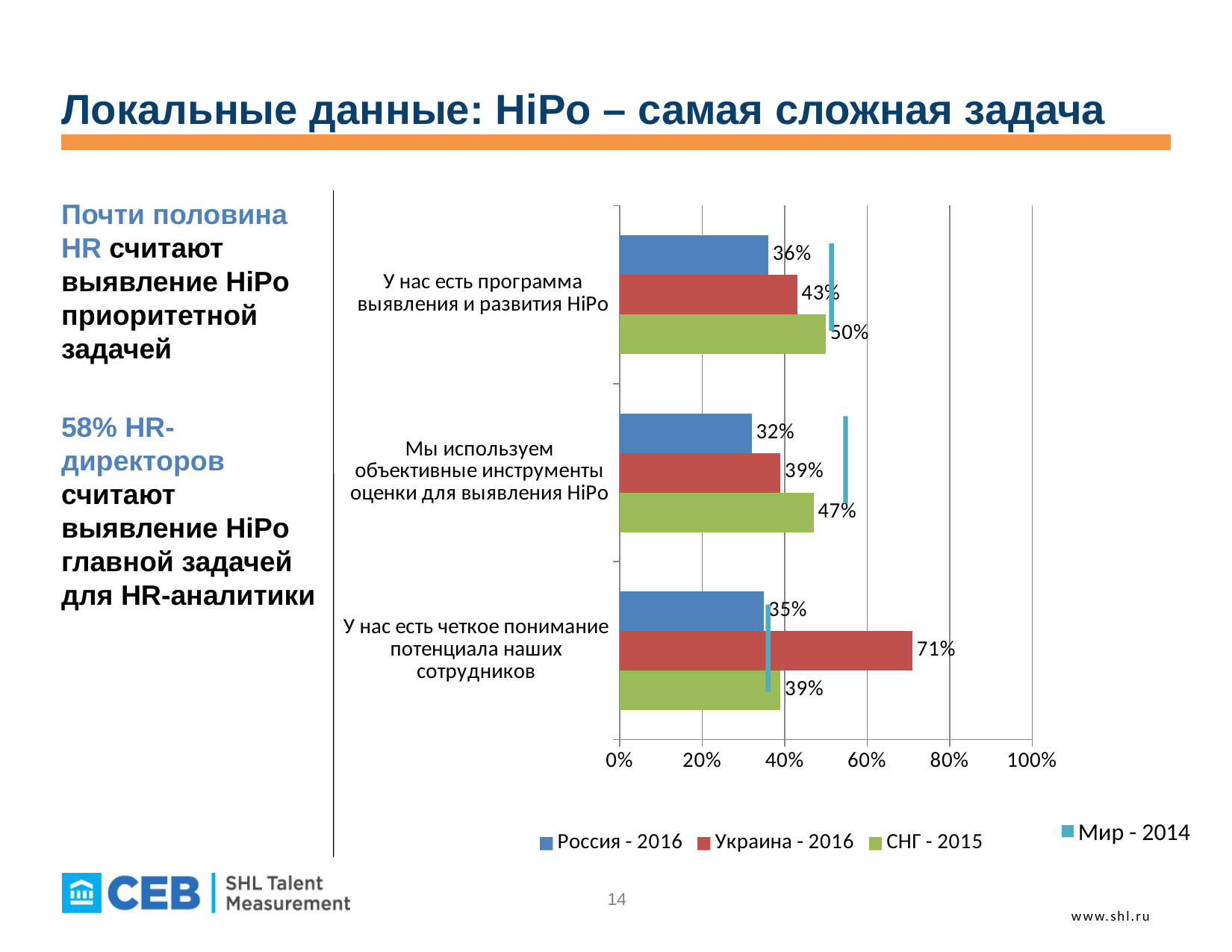
What is the value for Украина - 2016 for "У нас есть четкое понимание потенциала наших сотрудников"? 71% Is the Мир - 2014 value for "Мы используем объективные инструменты оценки для выявления HiPo" greater or less than 40%? greater How many series does the legend list? 4 What kind of chart is shown on the slide? Bar chart What is the value for Россия - 2016 for "У нас есть программа выявления и развития HiPo"? 36% Which series has the lowest value for "Мы используем объективные инструменты оценки для выявления HiPo"? Россия - 2016 What is the difference between Украина - 2016 and Россия - 2016 for "У нас есть четкое понимание потенциала наших сотрудников"? 36% Is the Мир - 2014 value for "У нас есть четкое понимание потенциала наших сотрудников" greater or less than 60%? less Which is larger for "У нас есть программа выявления и развития HiPo": Украина - 2016 or Россия - 2016? Украина - 2016 What is the value for СНГ - 2015 for "Мы используем объективные инструменты оценки для выявления HiPo"? 47% How many categories are shown on the chart? 3